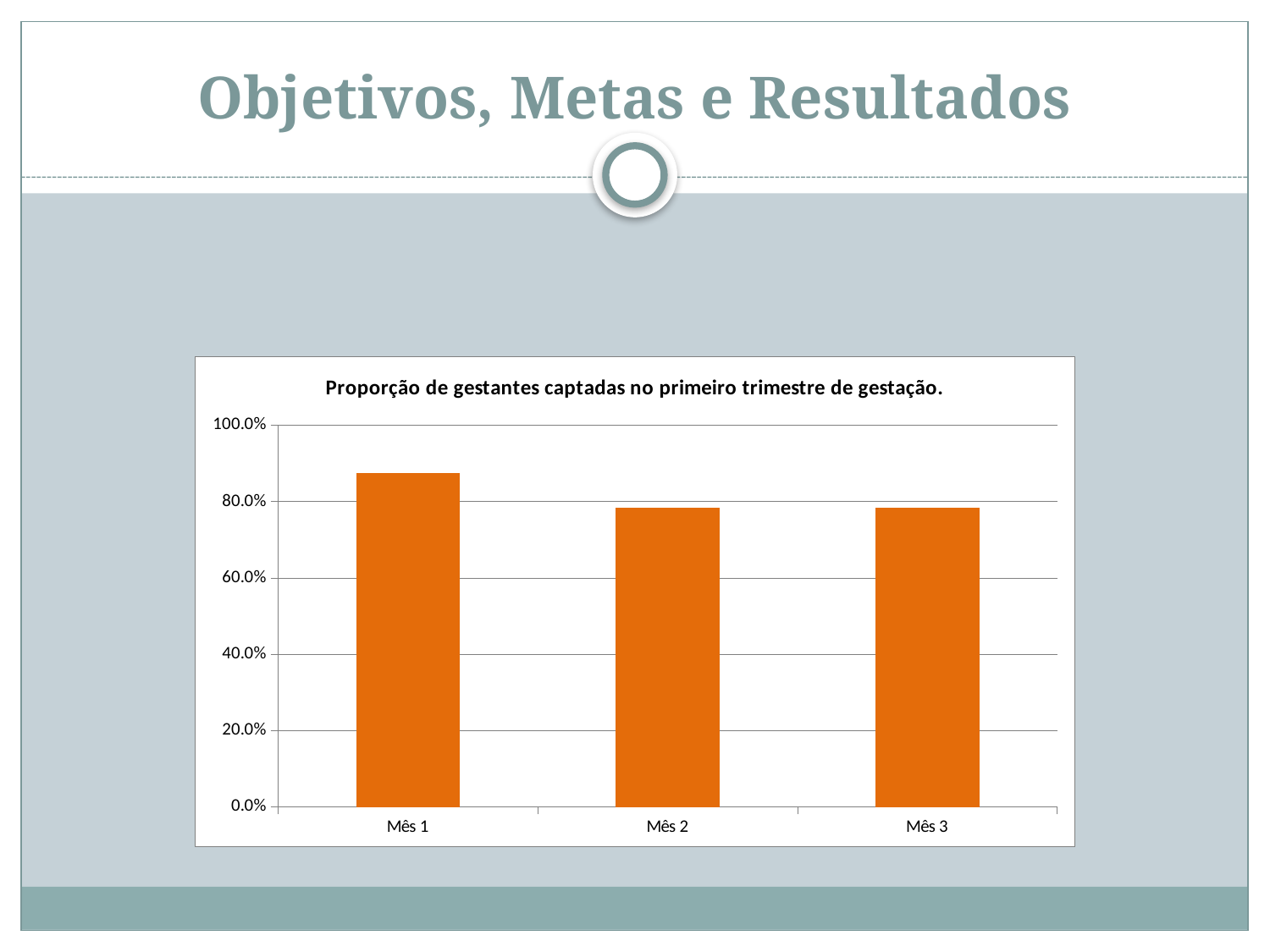
Is the value for Mês 2 greater or less than 60.0%? greater Does the value fall or rise from Mês 1 to Mês 2? fall What colour are the bars in the chart? orange Is the value for Mês 1 greater or less than 80.0%? greater What kind of chart is shown on the slide? bar chart What is the title of the chart? Proporção de gestantes captadas no primeiro trimestre de gestação. How many categories are shown on the x axis of the chart? 3 Is the value for Mês 1 greater or less than 100.0%? less Which month has the highest proportion in the chart? Mês 1 Which is larger, the value for Mês 1 or the value for Mês 2? Mês 1